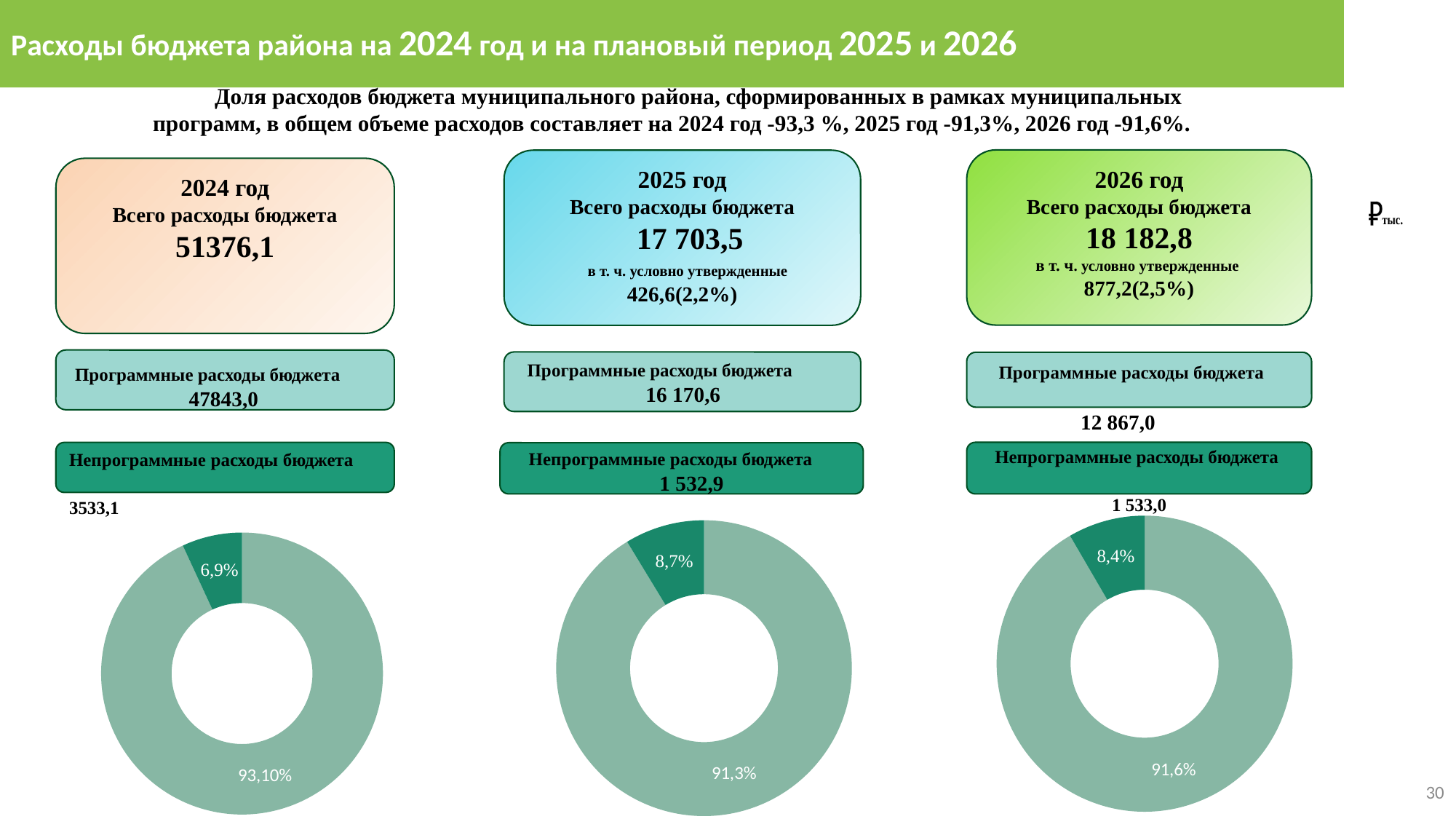
Which year's donut chart has the largest dark green (smaller) slice: 2024, 2025 or 2026? 2025 Which year's donut chart has the smallest dark green (smaller) slice: 2024, 2025 or 2026? 2024 Is the smaller slice in the 2025 donut chart larger or smaller than the smaller slice in the 2026 donut chart? larger What kind of chart is shown under the 2024 column? Donut (pie) chart In the 2024 donut chart, what percentage is shown on the smaller dark green slice? 6,9% In the 2025 donut chart, what percentage is shown on the larger slice? 91,3% In the 2026 donut chart, what percentage is shown on the larger slice? 91,6% In the 2026 donut chart, what percentage is shown on the smaller dark green slice? 8,4% How many donut charts are shown on the slide? 3 In the 2024 donut chart, what percentage is shown on the larger slice? 93,10% How many slices does each donut chart on the slide contain? 2 In the 2025 donut chart, what percentage is shown on the smaller dark green slice? 8,7%